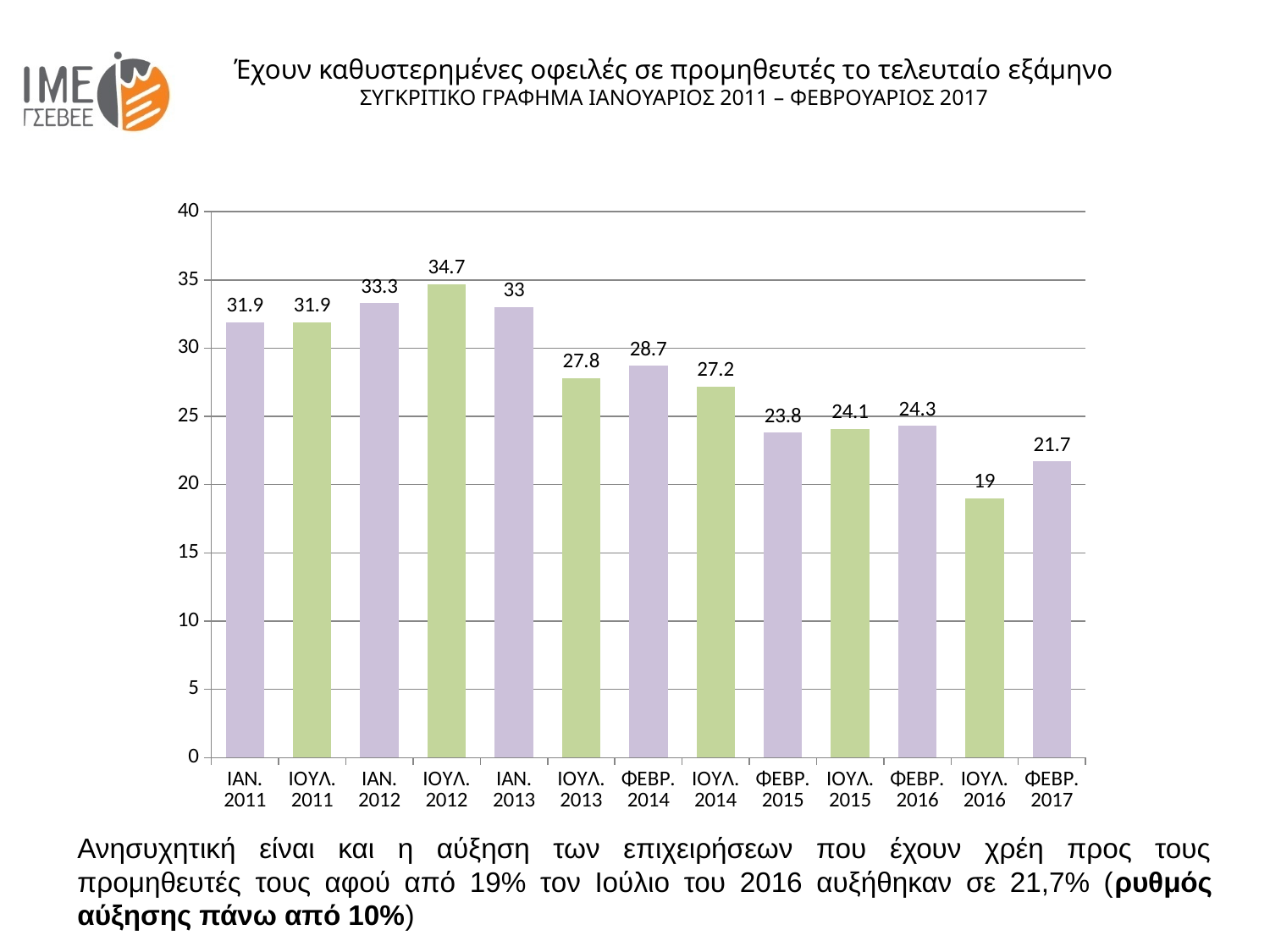
What is the difference between the values for ΦΕΒΡ. 2017 and ΙΟΥΛ. 2016? 2.7 Which is larger, the value for ΙΟΥΛ. 2013 or the value for ΦΕΒΡ. 2014? ΦΕΒΡ. 2014 Which category has the highest value? ΙΟΥΛ. 2012 Do the values generally rise or fall from ΙΑΝ. 2011 to ΦΕΒΡ. 2017? Fall What is the value for ΙΟΥΛ. 2012? 34.7 What is the value for ΦΕΒΡ. 2017? 21.7 Which category has the lowest value? ΙΟΥΛ. 2016 What is the value for ΙΟΥΛ. 2016? 19 What kind of chart is shown on the slide? Bar chart What is the value for ΦΕΒΡ. 2014? 28.7 How many categories are shown on the x axis? 13 What is the difference between the values for ΙΟΥΛ. 2012 and ΙΑΝ. 2013? 1.7